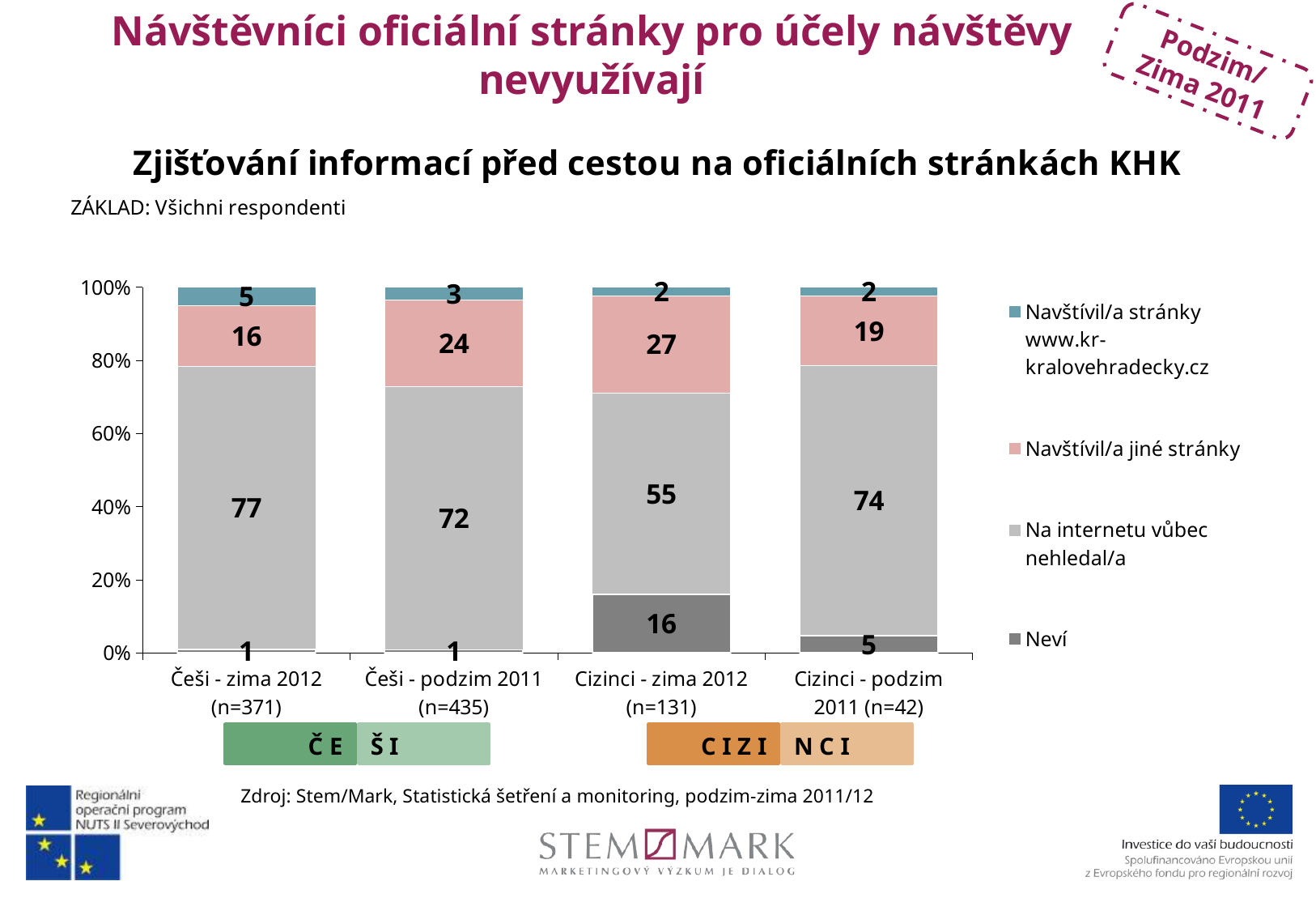
What kind of chart is shown? Stacked bar chart What is the value for "Navštívil/a stránky www.kr-kralovehradecky.cz" for Češi - podzim 2011 (n=435)? 3 What is the value for "Navštívil/a jiné stránky" for Cizinci - zima 2012 (n=131)? 27 What is the difference between the "Navštívil/a jiné stránky" values for Češi - podzim 2011 and Češi - zima 2012? 8 How many series does the legend list? 4 Which is larger: the "Navštívil/a stránky www.kr-kralovehradecky.cz" value for Češi - zima 2012 or for Cizinci - zima 2012? Češi - zima 2012 What is the total of the stacked bar for Cizinci - zima 2012 (n=131)? 100 Which category has the lowest value for "Na internetu vůbec nehledal/a"? Cizinci - zima 2012 (n=131) How many categories are shown on the x axis? 4 What is the value for "Neví" for Cizinci - podzim 2011 (n=42)? 5 What is the value for "Na internetu vůbec nehledal/a" for Češi - zima 2012 (n=371)? 77 Which category has the highest value for "Neví"? Cizinci - zima 2012 (n=131)